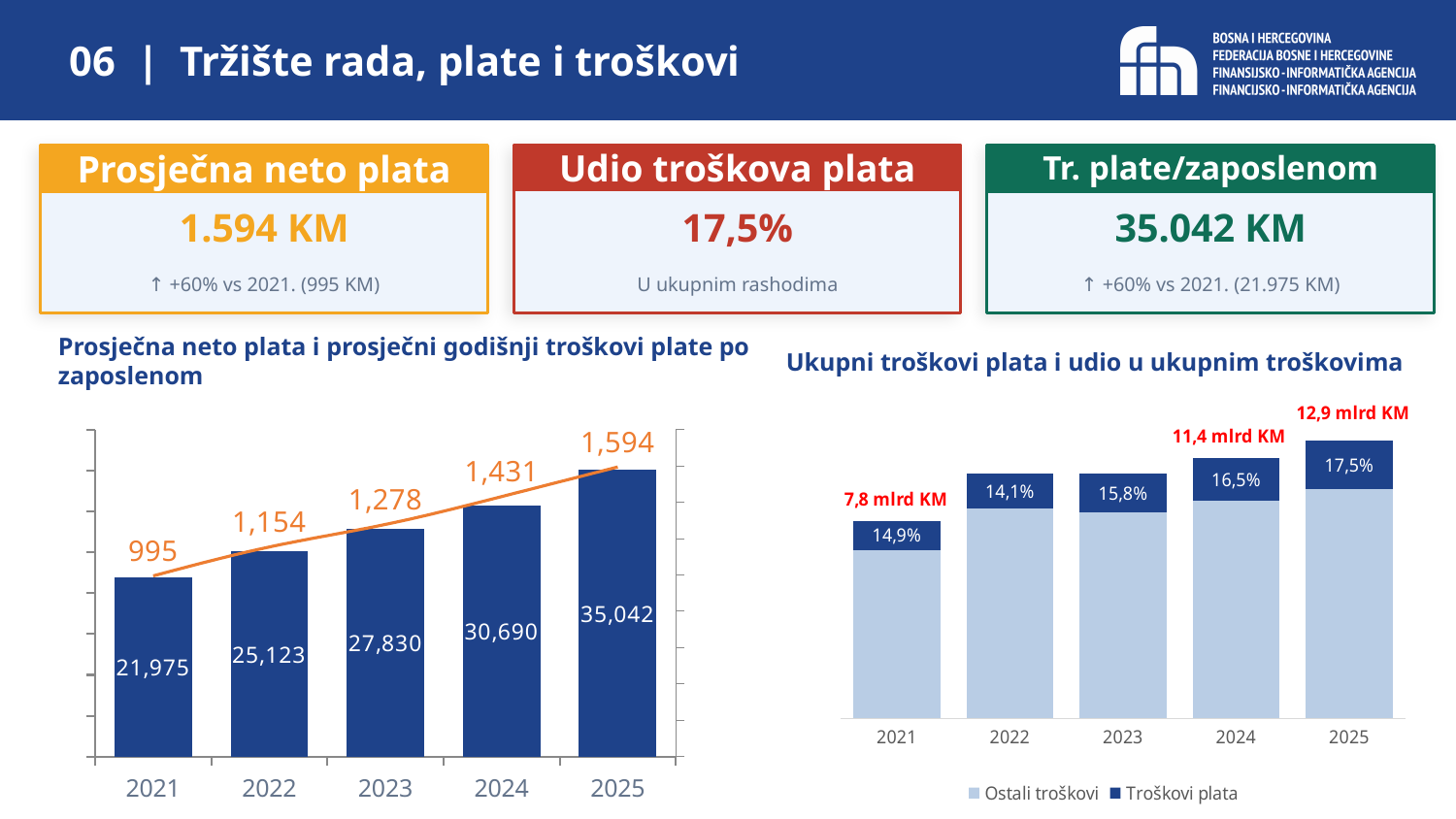
In the left chart, do the bar values rise or fall from 2021 to 2025? rise In the left chart, what is the line value for 2022? 1,154 In the left chart, what is the difference between the line values for 2025 and 2021? 599 In the left chart, which year has the lowest line value? 2021 In the right chart (Ukupni troškovi plata i udio u ukupnim troškovima), what percentage is shown for 2024? 16,5% In the left chart (Prosječna neto plata i prosječni godišnji troškovi plate po zaposlenom), what is the bar value for 2023? 27,830 In the right chart, what total is labelled above the 2025 bar? 12,9 mlrd KM In the left chart, what is the difference between the bar values for 2025 and 2021? 13,067 How many series does the legend of the right chart list? 2 In the left chart, which year has the highest bar value? 2025 How many years are shown on the x axis of the left chart? 5 In the right chart, which year has the lowest percentage label? 2022